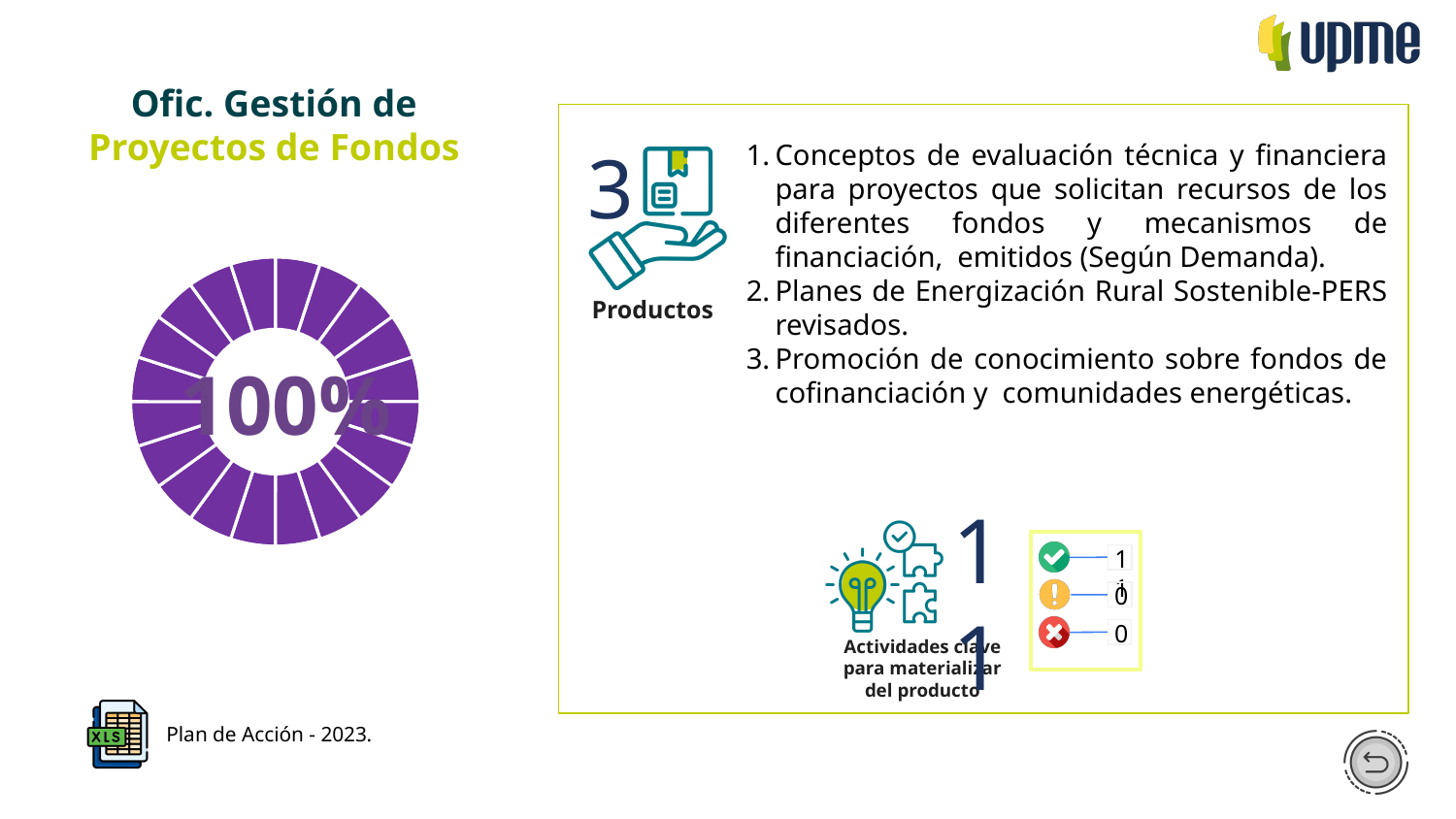
What percentage is displayed in the centre of the doughnut chart on the left of the slide? 100% In the status box next to the 'Actividades clave' icon, what number is shown beside the green check mark? 1 What colour are the segments of the doughnut chart? purple What kind of chart is shown on the left side of the slide? doughnut chart In the status box next to the 'Actividades clave' icon, what number is shown beside the red X? 0 What share of the doughnut chart is filled in purple, according to the label in its centre? 100% How many charts are on the slide? 1 Is the value shown in the doughnut chart greater or less than 50%? greater